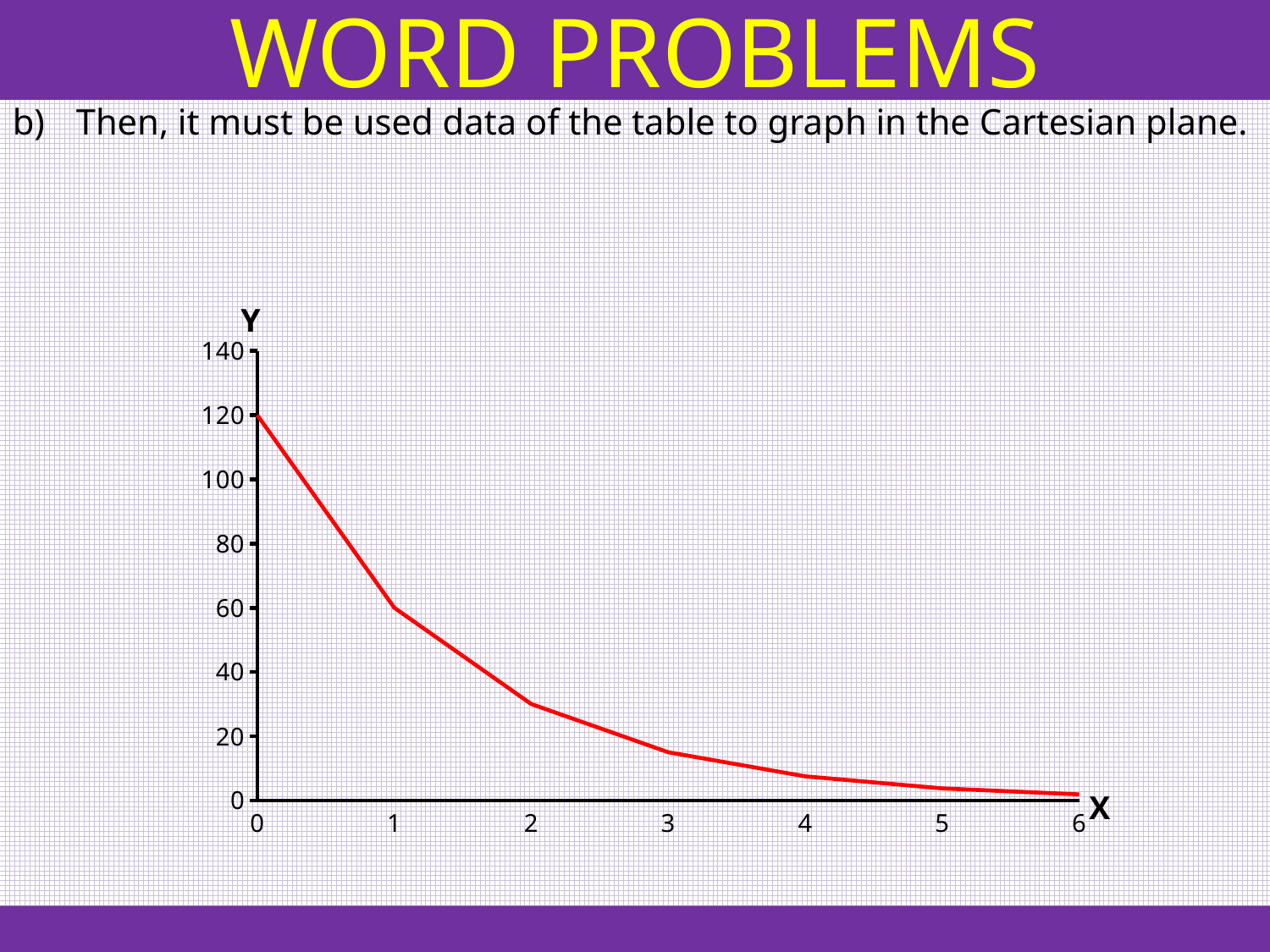
At which X value is Y lowest? 6 What is the difference between the Y value at X = 0 and the Y value at X = 1? 60 Which is larger, the Y value at X = 1 or the Y value at X = 2? X = 1 Is the value of Y at X = 6 greater or less than 20? less Is the value of Y at X = 3 greater or less than 20? less At which X value is Y highest? 0 What type of chart is shown on the slide? line chart Do the Y values rise or fall as X increases? fall Is the value of Y at X = 4 greater or less than 20? less What is the value of Y when X is 1? 60 What is the value of Y when X is 0? 120